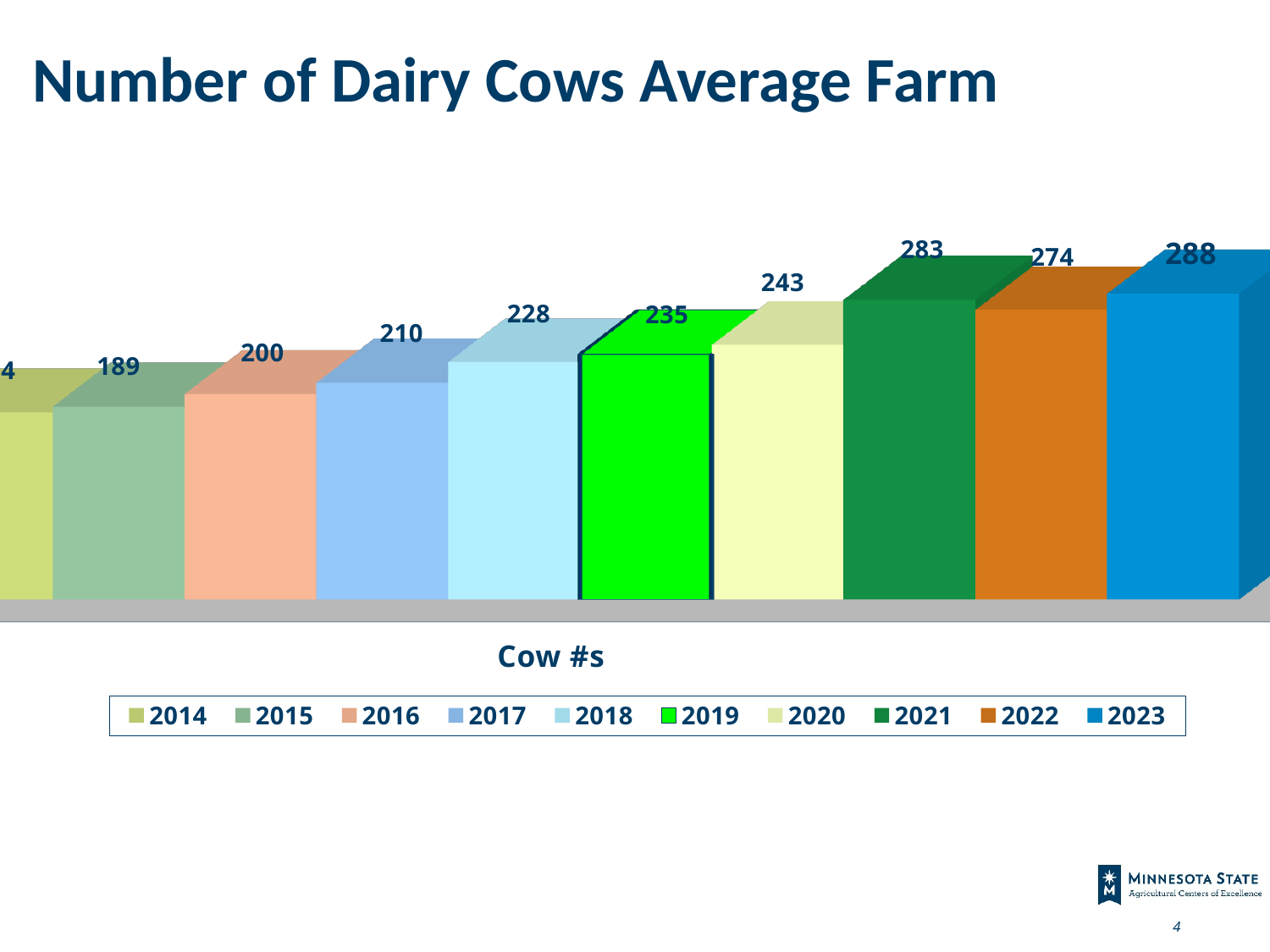
Which year has the highest value? 2023 Do the values rise or fall from 2015 to 2021? rise How many series does the legend list? 10 What is the difference between the values for 2021 and 2020? 40 What is the value for 2023? 288 What is the value for 2016? 200 What is the value for 2021? 283 What kind of chart is shown on the slide? bar chart What is the difference between the values for 2023 and 2022? 14 What is the value for 2018? 228 Which is larger, the value for 2021 or the value for 2022? 2021 What is the label shown below the bars on the x axis? Cow #s